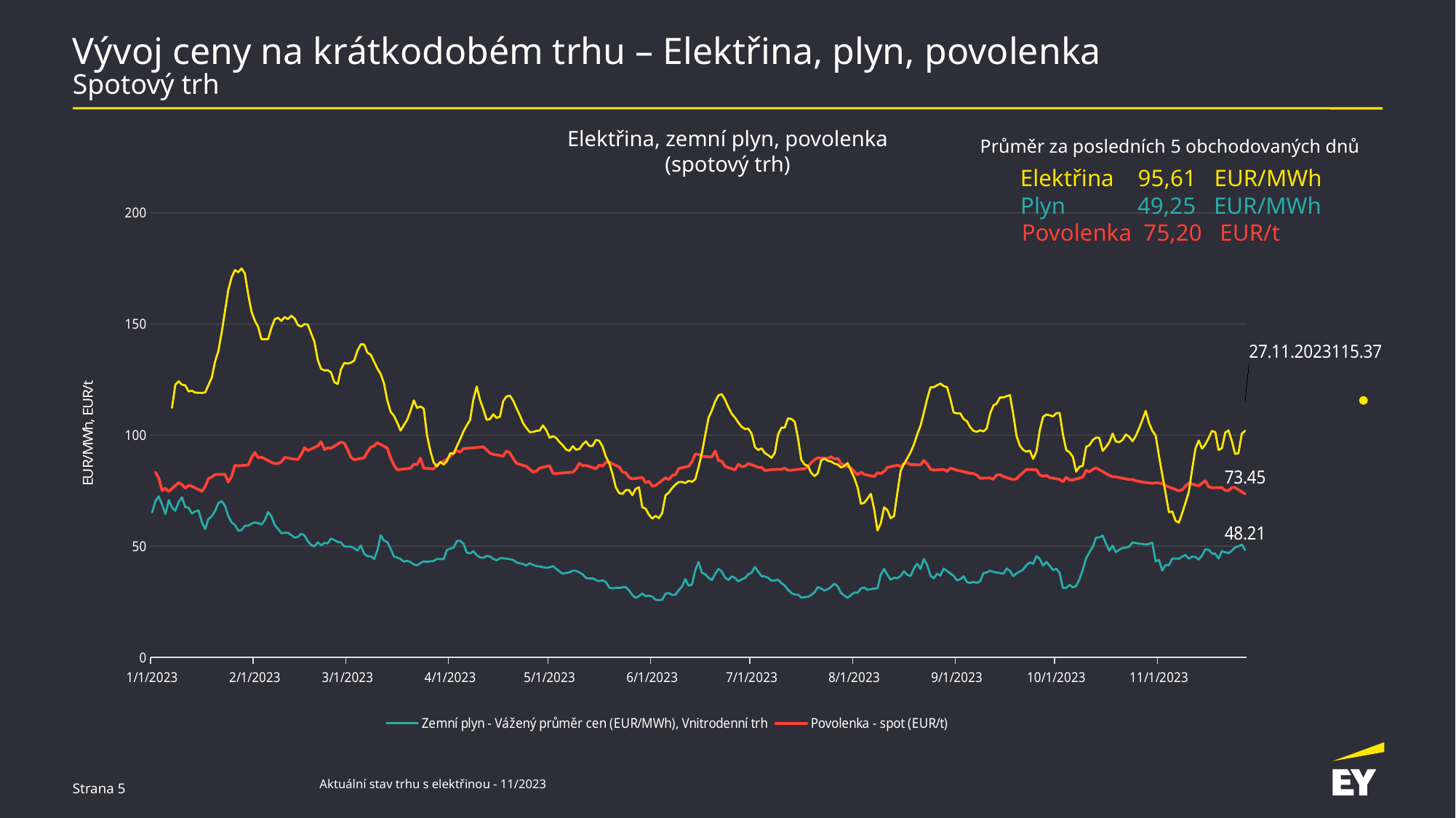
Does the Zemní plyn line rise or fall between 1/1/2023 and 6/1/2023? fall What is the difference between the last labelled Povolenka value (73.45) and the last labelled Zemní plyn value (48.21)? 25.24 What kind of chart is shown on the slide? line chart Is the peak of the yellow electricity line in late January 2023 greater or less than 150? greater What is the last labelled value of the Zemní plyn series? 48.21 At the end of the chart, which is larger: the Povolenka - spot value or the Zemní plyn value? Povolenka - spot What is the difference between the labelled electricity value on 27.11.2023 (115.37) and the last labelled Povolenka value (73.45)? 41.92 What is the title of the chart? Elektřina, zemní plyn, povolenka (spotový trh) How many series does the chart legend list? 2 Is the Zemní plyn value around 6/1/2023 greater or less than 50? less What value is labelled for the yellow electricity series on 27.11.2023? 115.37 What is the last labelled value of the Povolenka - spot (EUR/t) series? 73.45